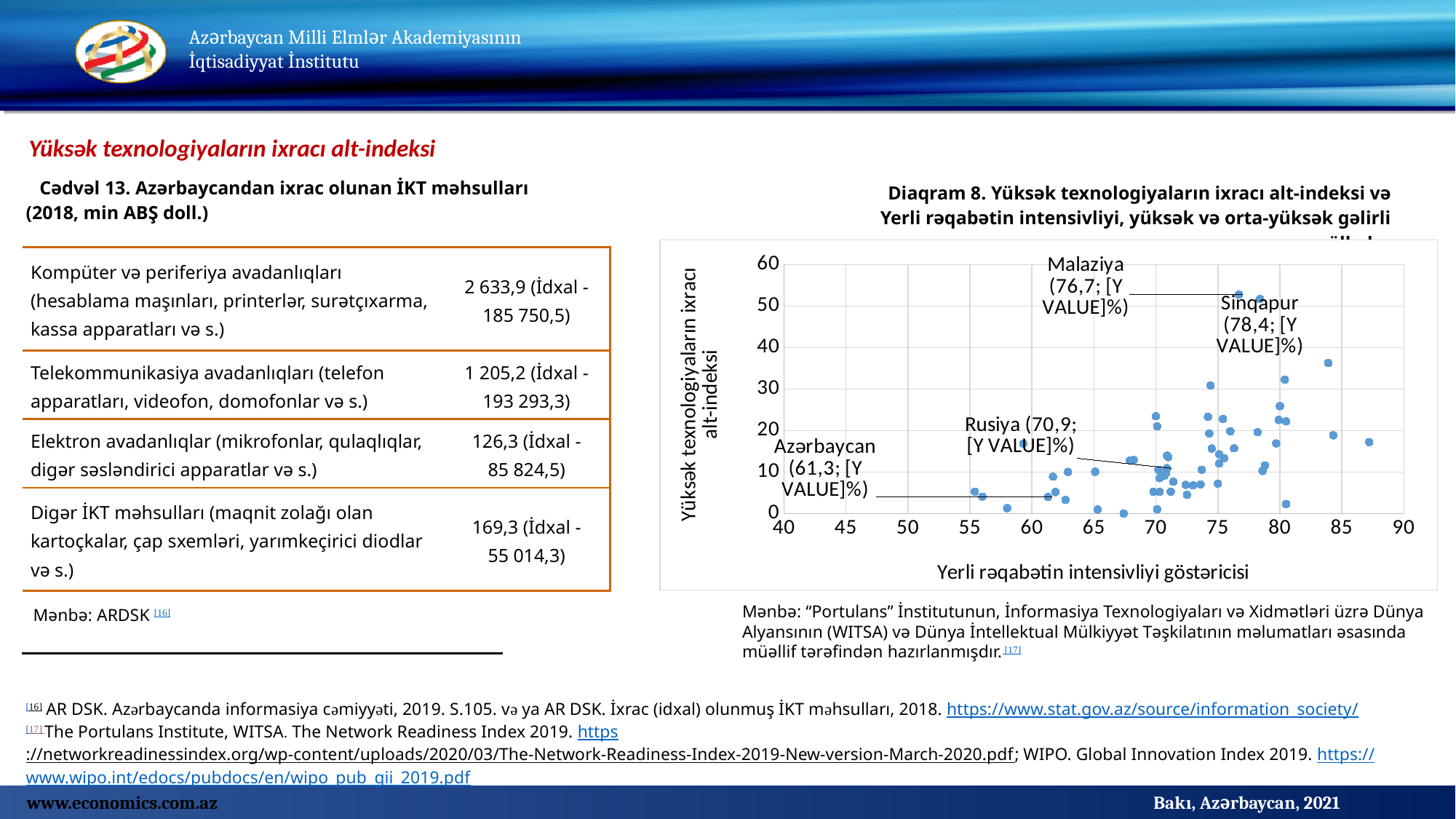
In Diaqram 8, what is the difference between the Yerli rəqabətin intensivliyi values of Sinqapur and Azərbaycan? 17,1 In Diaqram 8, how many countries are labeled by name on the chart? 4 In Diaqram 8, what is the Yerli rəqabətin intensivliyi value shown in the data label for Sinqapur? 78,4 In Diaqram 8, what is the Yerli rəqabətin intensivliyi value shown in the data label for Azərbaycan? 61,3 In Diaqram 8, is the Yüksək texnologiyaların ixracı alt-indeksi value for Malaziya greater or less than 40? greater In Diaqram 8, what is the Yerli rəqabətin intensivliyi value shown in the data label for Malaziya? 76,7 In Diaqram 8, is the Yüksək texnologiyaların ixracı alt-indeksi value for Azərbaycan greater or less than 10? less In Diaqram 8, which of the labeled countries has the highest Yerli rəqabətin intensivliyi value? Sinqapur What kind of chart is Diaqram 8? scatter chart In Diaqram 8, what is the title of the horizontal axis? Yerli rəqabətin intensivliyi göstəricisi In Diaqram 8, what is the Yerli rəqabətin intensivliyi value shown in the data label for Rusiya? 70,9 In Diaqram 8, which of the labeled countries has the lowest Yerli rəqabətin intensivliyi value? Azərbaycan